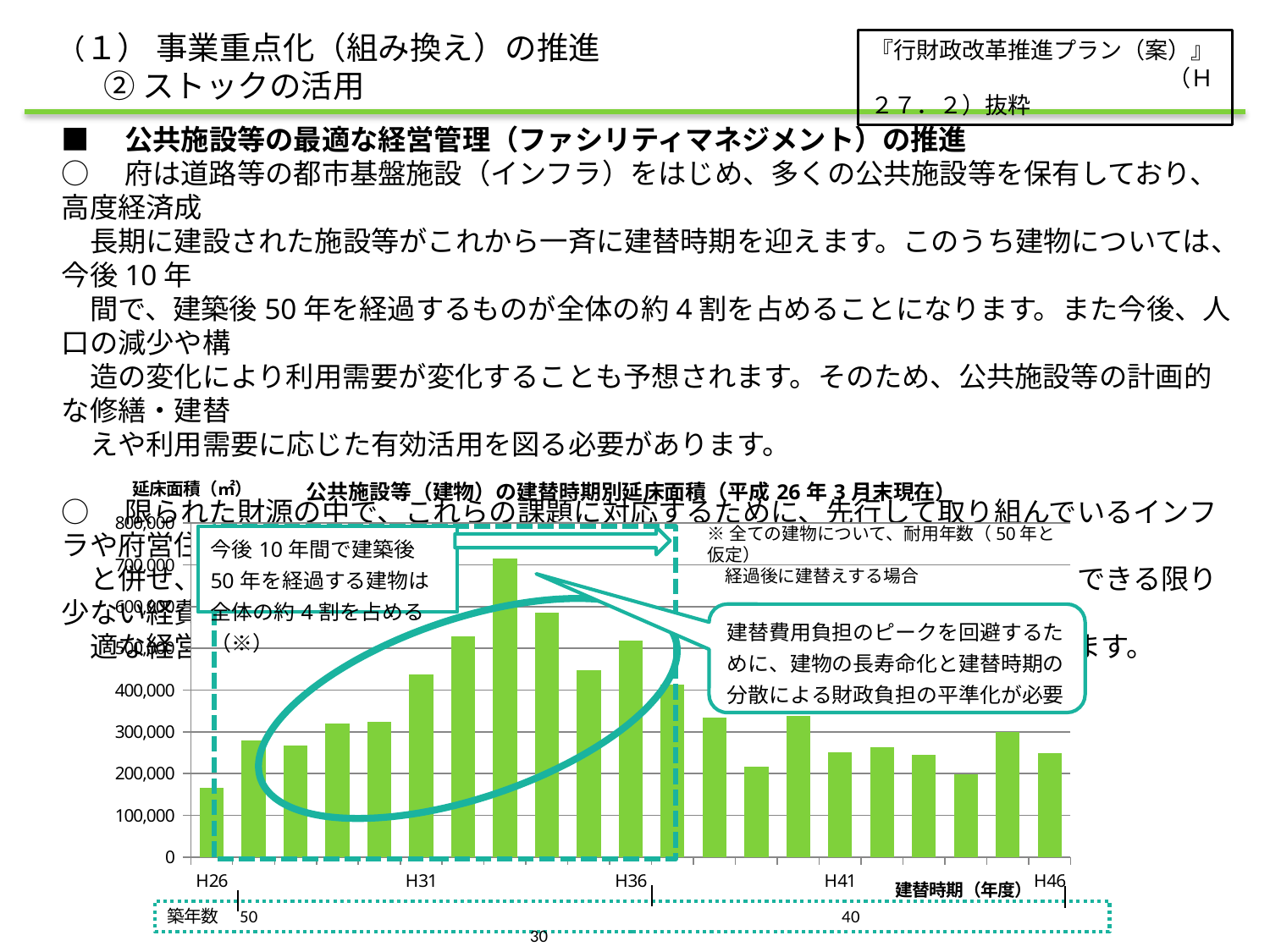
What is the title of the chart? 公共施設等（建物）の建替時期別延床面積（平成26年3月末現在） Is the value for H26 greater or less than 200,000? less What kind of chart is shown on the slide? bar chart How many bars are plotted in the chart? 21 Which labeled year on the x axis has the lowest bar? H26 Is the value for H41 greater or less than 300,000? less Which is larger, the value for H36 or the value for H46? H36 Which is larger, the value for H31 or the value for H41? H31 Is the value for H31 greater or less than 400,000? greater What is the label of the vertical axis of the chart? 延床面積（㎡）